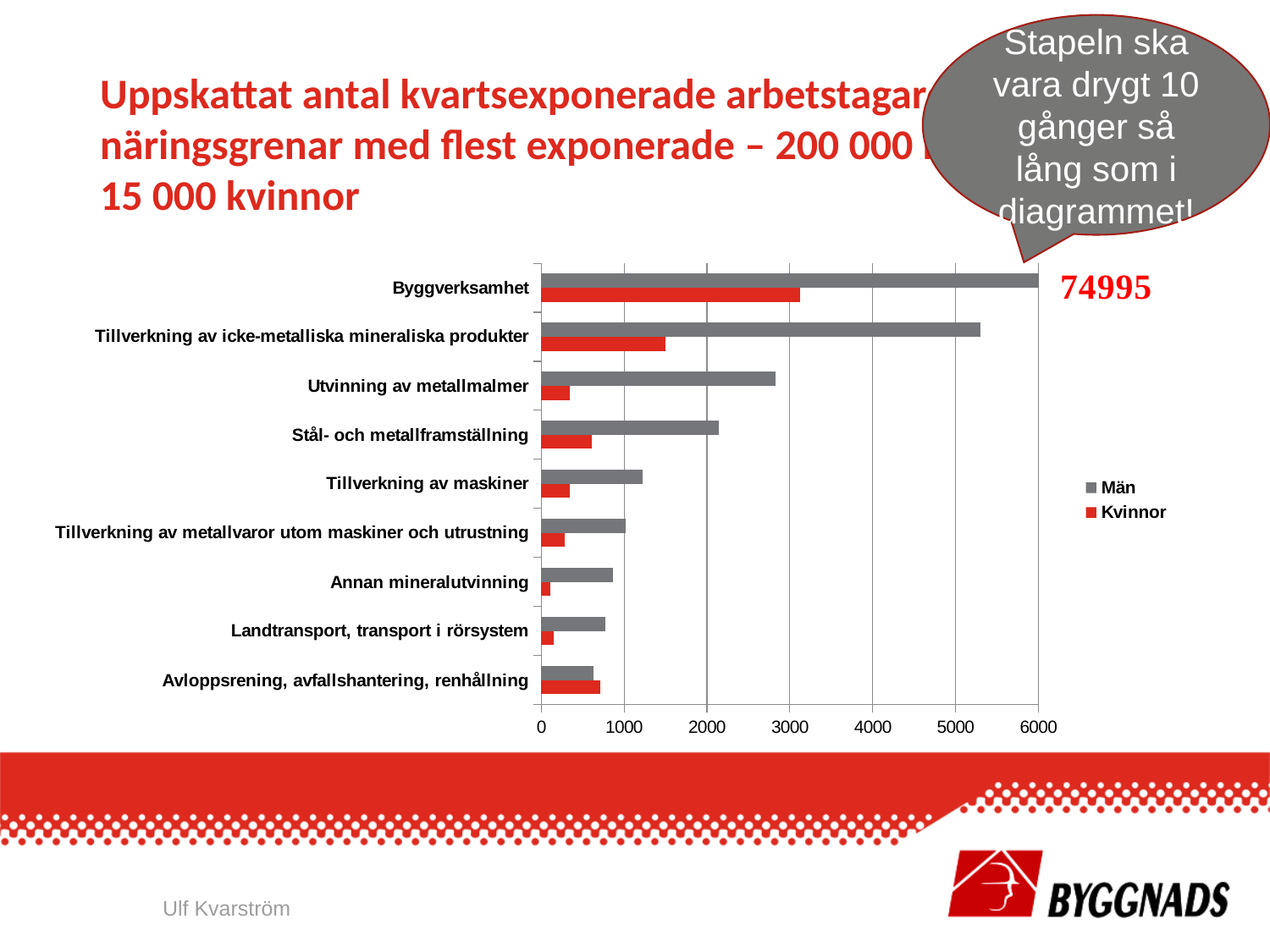
How many series does the legend list? 2 Which category has the highest value for Män? Byggverksamhet How many industry categories are plotted on the chart? 9 What kind of chart is shown on the slide? bar chart Is the Män value for Tillverkning av icke-metalliska mineraliska produkter greater or less than 5000? greater Is the Män value for Annan mineralutvinning greater or less than 1000? less What colour are the Kvinnor bars? red What are the two series named in the legend? Män and Kvinnor Which category has the lowest value for Kvinnor? Annan mineralutvinning Which is larger, the Män value for Utvinning av metallmalmer or the Män value for Stål- och metallframställning? Utvinning av metallmalmer Is the Män value for Utvinning av metallmalmer greater or less than 3000? less What value is printed next to the Män bar for Byggverksamhet? 74995